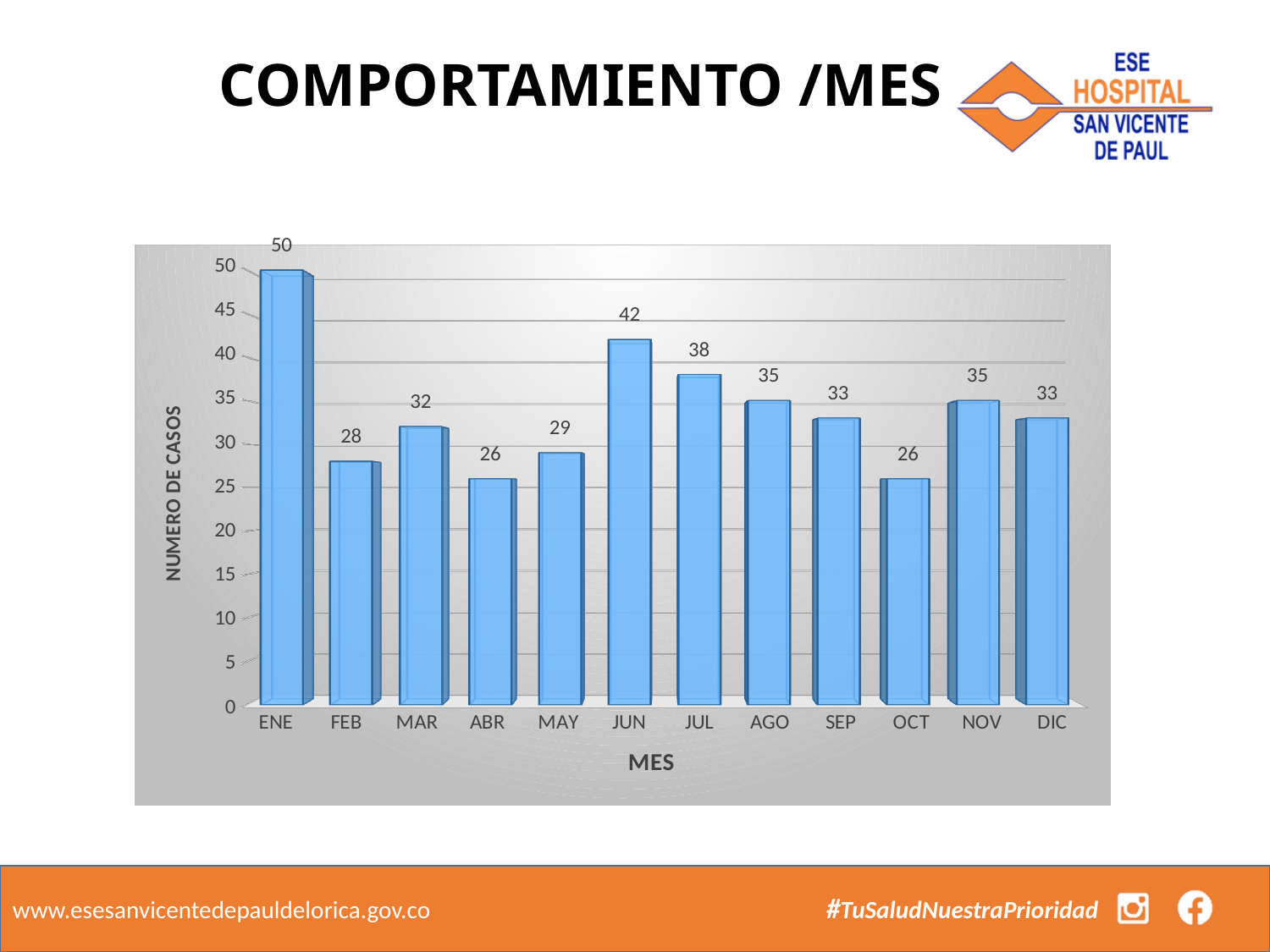
Is the value for AGO greater or less than 30? greater What is the difference in number of cases between ENE and FEB? 22 How many months are shown on the x axis? 12 Which has more cases, MAR or MAY? MAR What is the difference in number of cases between JUN and JUL? 4 What is the number of cases for ENE? 50 What is the label of the vertical axis? NUMERO DE CASOS Which months have the lowest number of cases? ABR and OCT What kind of chart is shown on the slide? Bar chart What is the number of cases for JUN? 42 Which month has the highest number of cases? ENE What is the number of cases for OCT? 26